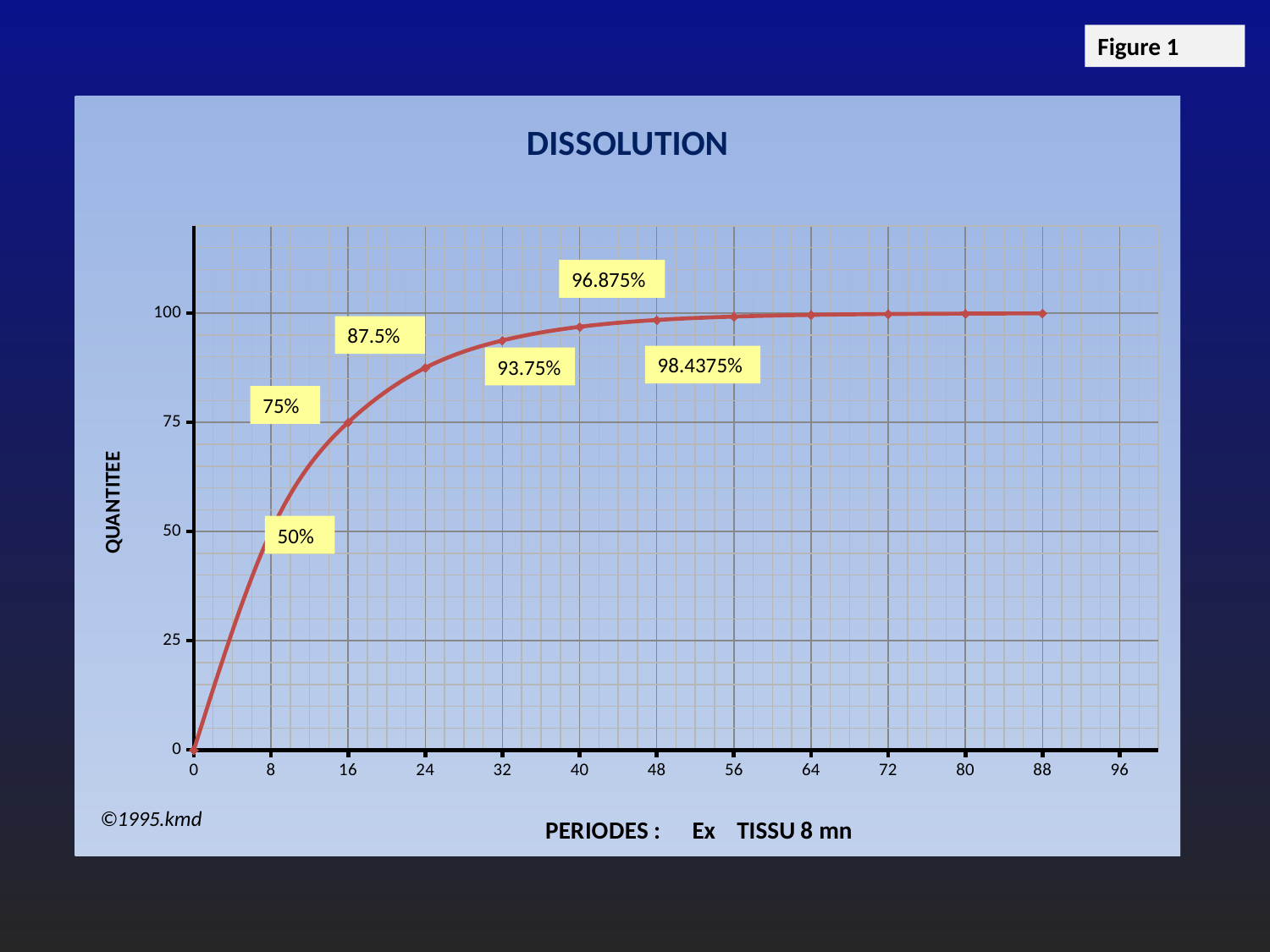
What is the labelled value of the curve at period 32? 93.75% What is the title of the chart? DISSOLUTION What is the labelled value of the curve at period 48? 98.4375% What is the labelled value of the curve at period 40? 96.875% Do the values rise or fall as the periods increase along the x axis? rise Is the value of the curve at period 56 greater or less than 75? greater What is the labelled value of the curve at period 24? 87.5% What kind of chart is shown on the slide? line chart What is the labelled value of the curve at period 8? 50% What is the labelled value of the curve at period 16? 75% Which period has the larger value, 24 or 8? 24 What is the difference between the labelled values at period 16 and period 8? 25%